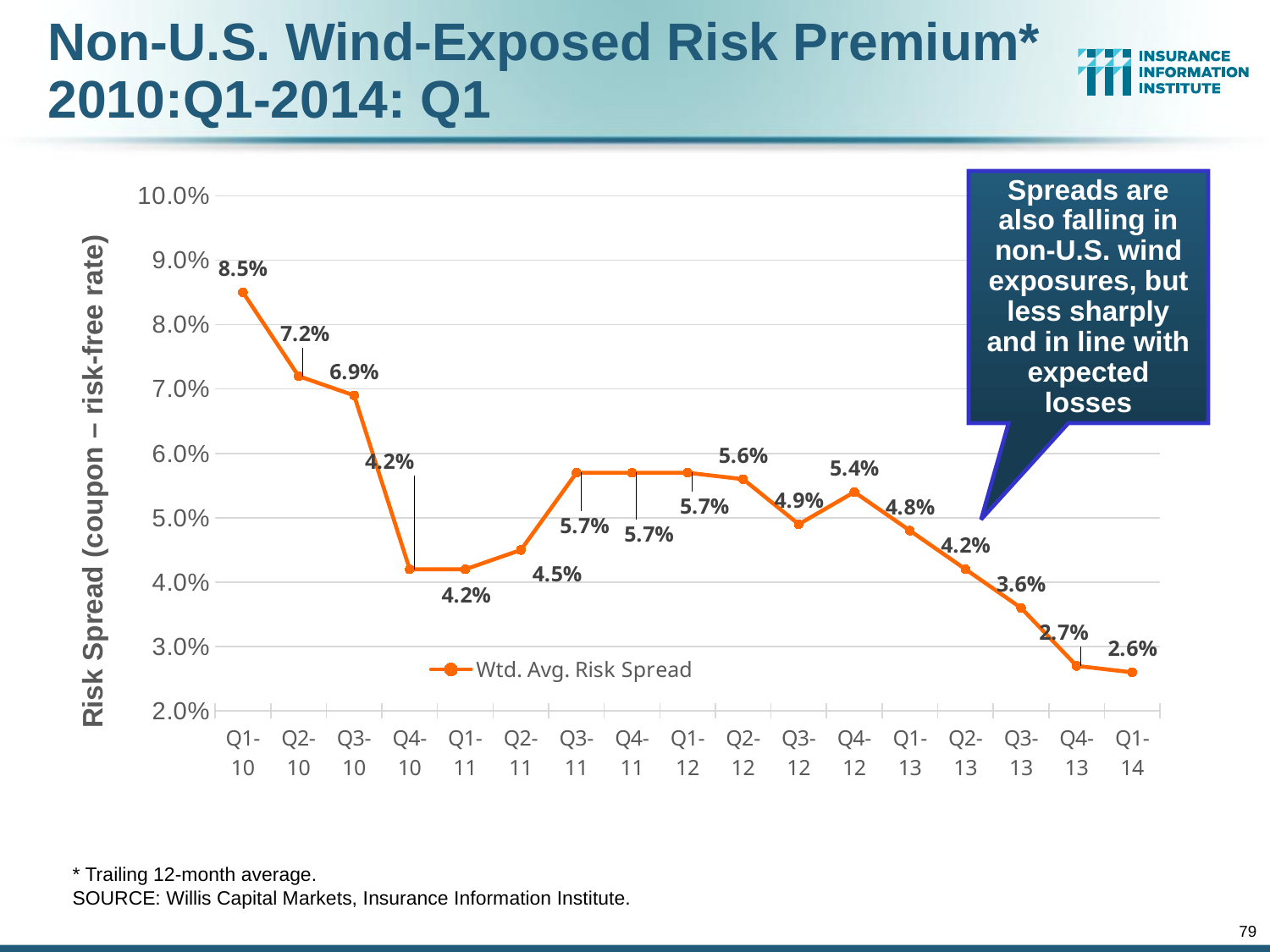
How many quarters are plotted on the chart? 17 Which quarter has the lowest weighted average risk spread? Q1-14 Which is larger, the risk spread in Q3-12 or Q4-12? Q4-12 What is the weighted average risk spread for Q1-10? 8.5% What is the name of the series shown in the legend? Wtd. Avg. Risk Spread What is the difference between the risk spread in Q1-10 and Q1-14? 5.9% What is the weighted average risk spread for Q3-13? 3.6% What type of chart is shown on the slide? Line chart Which quarter has the highest weighted average risk spread? Q1-10 What is the weighted average risk spread for Q1-14? 2.6% Is the risk spread for Q2-10 greater or less than 7.0%? greater What is the weighted average risk spread for Q4-12? 5.4%